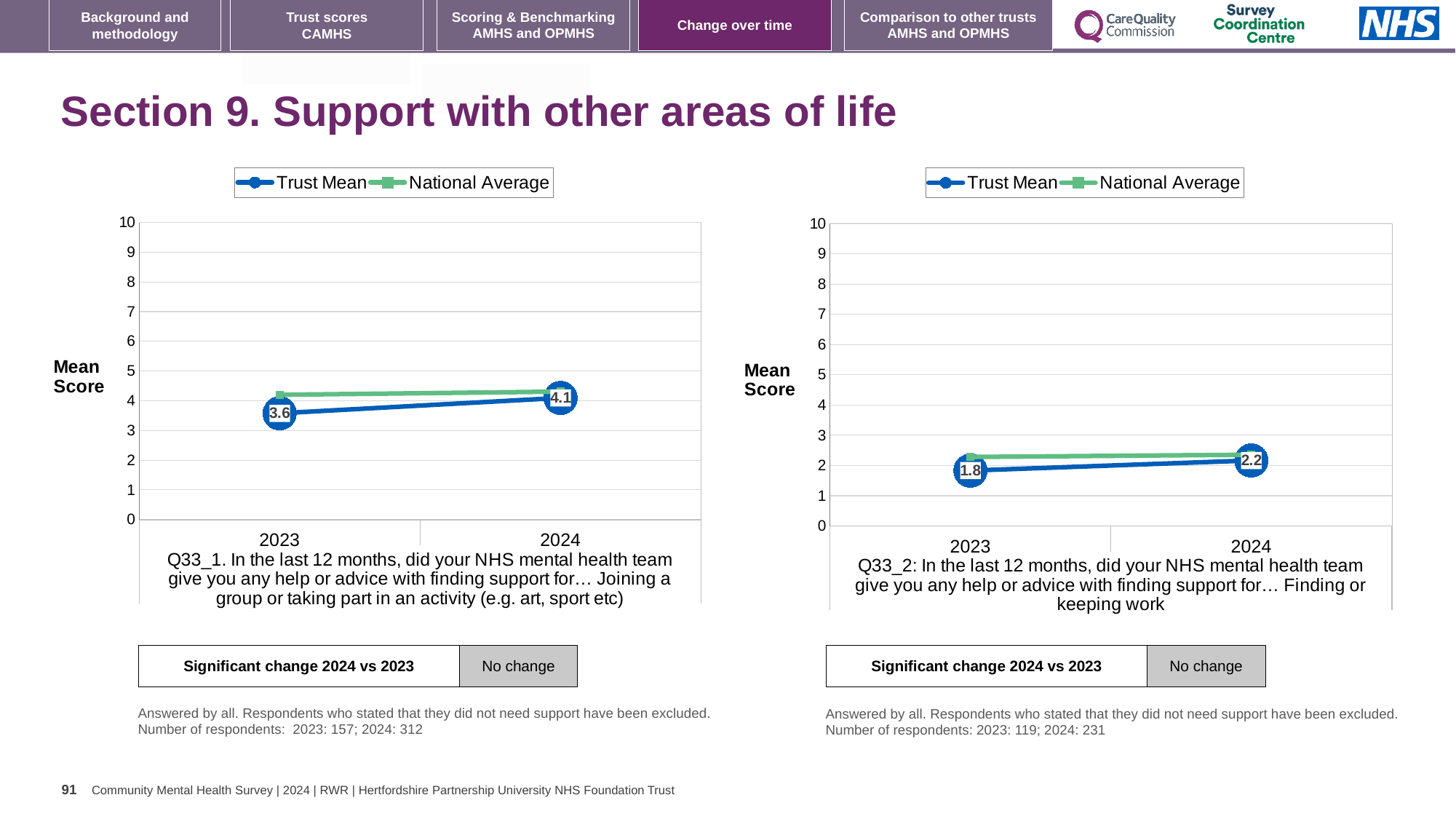
In the left chart (Q33_1), by how much did the Trust Mean change from 2023 to 2024? 0.5 In the left chart (Q33_1), does the Trust Mean rise or fall from 2023 to 2024? rise In the left chart (Q33_1), what is the Trust Mean score for 2024? 4.1 What kind of chart is the right chart (Q33_2)? line chart In the right chart (Q33_2), which year has the higher Trust Mean, 2023 or 2024? 2024 How many series does the legend of the left chart (Q33_1) list? 2 In the left chart (Q33_1), is the National Average for 2023 greater or less than 5? less In the right chart (Q33_2), what is the Trust Mean score for 2023? 1.8 In the left chart (Q33_1), what is the Trust Mean score for 2023? 3.6 In the right chart (Q33_2), what is the Trust Mean score for 2024? 2.2 In the right chart (Q33_2), by how much did the Trust Mean change from 2023 to 2024? 0.4 In the right chart (Q33_2), is the National Average for 2024 greater or less than 3? less